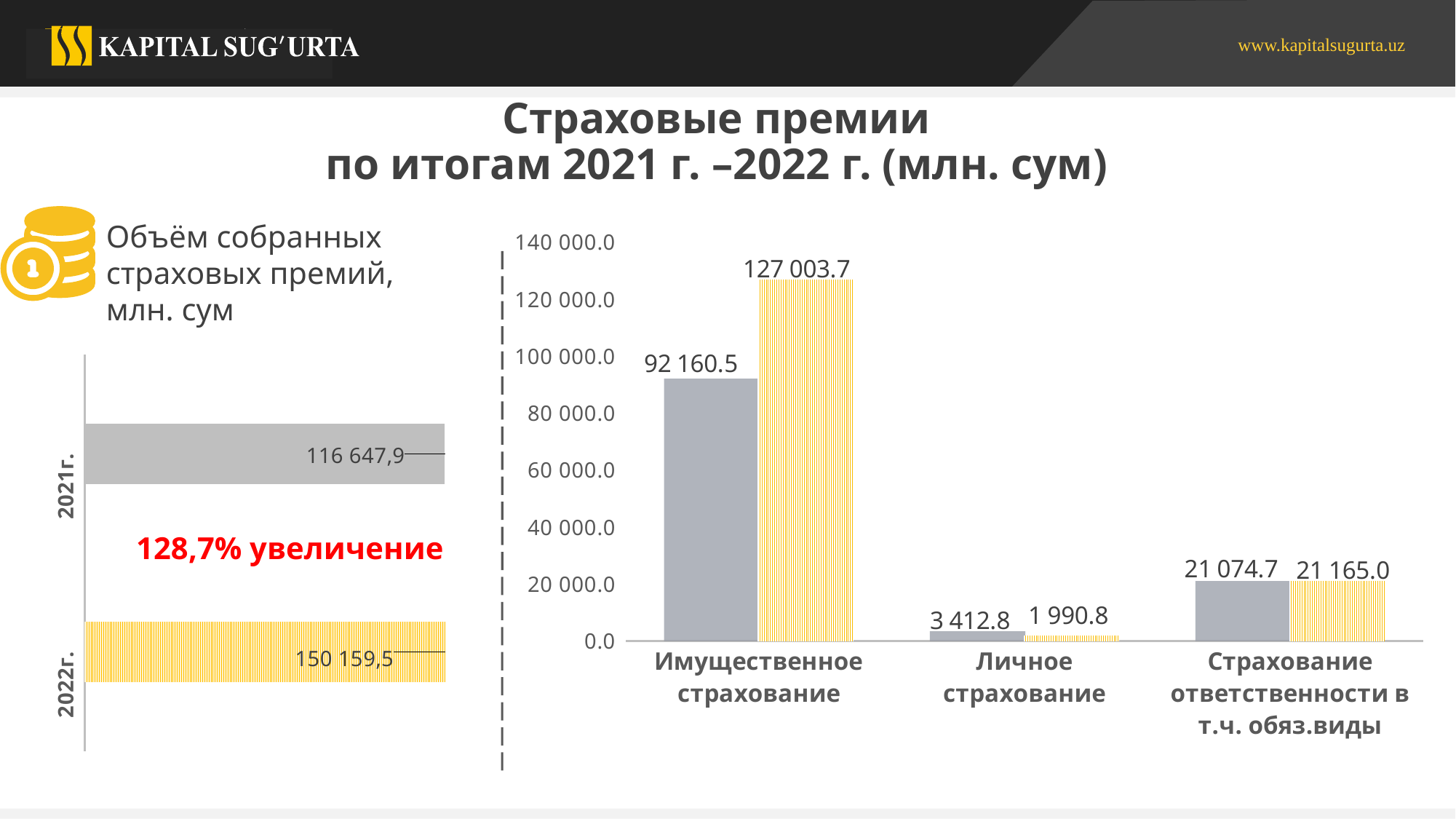
On the right chart, which category has the highest value overall? Имущественное страхование On the left chart, what percentage increase is stated in red text? 128,7% увеличение On the right chart, how many categories are shown on the x axis? 3 On the right chart, what is the value of the yellow striped bar for Страхование ответственности в т.ч. обяз.виды? 21 165.0 On the left chart, what is the value for 2022г.? 150 159,5 On the right chart, what is the value of the grey bar for Личное страхование? 3 412.8 On the right chart, what is the value of the grey bar for Имущественное страхование? 92 160.5 On the left chart, what is the value for 2021г.? 116 647,9 What type of chart is the right chart? Bar chart On the right chart, which category has the lowest value overall? Личное страхование On the right chart, what is the value of the yellow striped bar for Имущественное страхование? 127 003.7 On the left chart, which year has the higher value, 2021г. or 2022г.? 2022г.